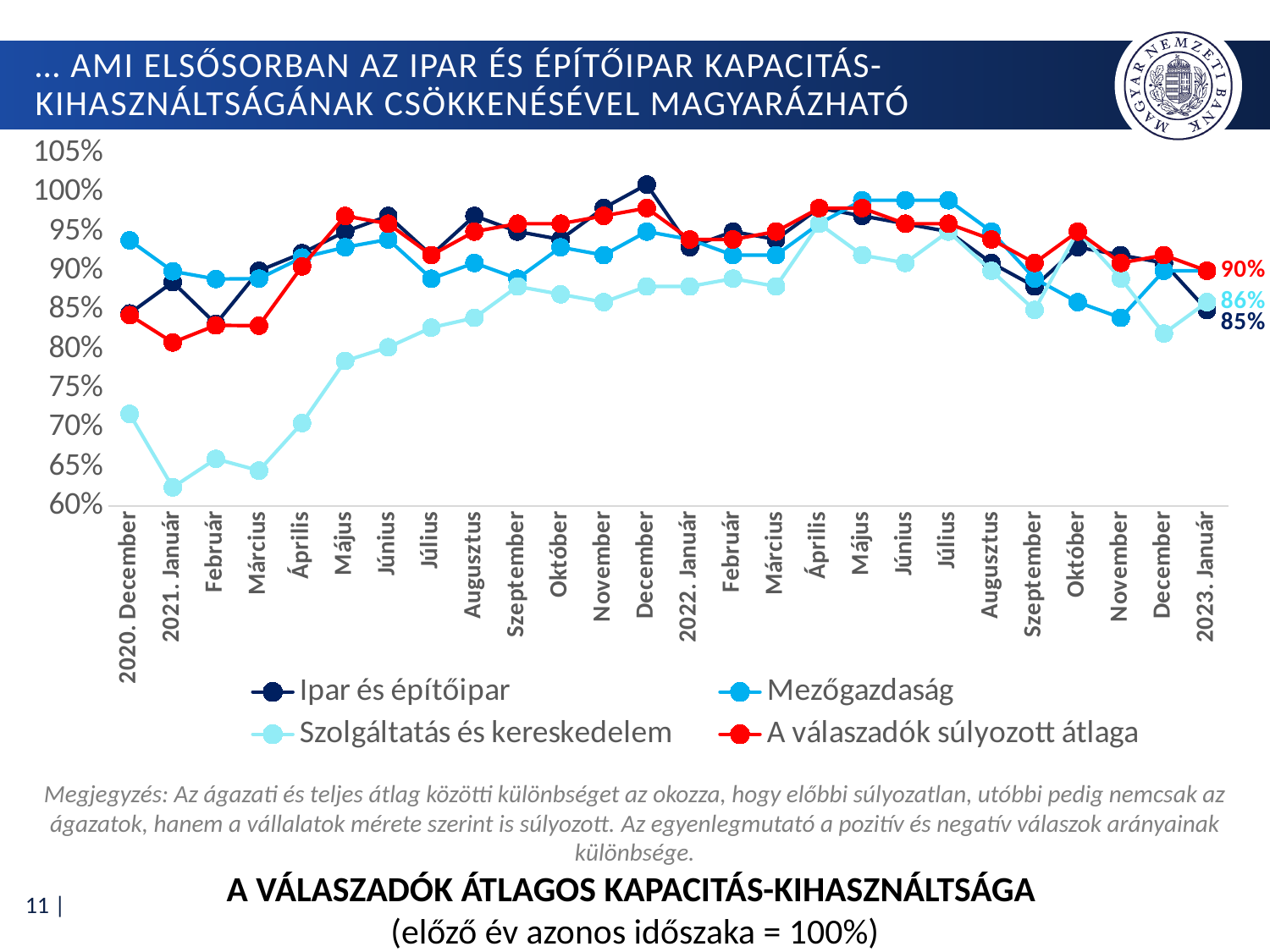
How many series does the legend list? 4 What is the value of 'A válaszadók súlyozott átlaga' in 2023. Január? 90% Is the value for 'Ipar és építőipar' in 2021 December greater or less than 100%? greater In which month does 'Szolgáltatás és kereskedelem' reach its lowest value? 2021. Január What is the value of 'Ipar és építőipar' in 2023. Január? 85% How many months (points) are shown along the x axis? 26 In which month does 'Ipar és építőipar' reach its highest value? 2021 December In 2023. Január, what is the difference between 'A válaszadók súlyozott átlaga' and 'Ipar és építőipar'? 5 percentage points Is the value for 'Szolgáltatás és kereskedelem' in 2021. Január greater or less than 65%? less In 2021. Január, which is larger: 'Ipar és építőipar' or 'Szolgáltatás és kereskedelem'? Ipar és építőipar What is the value of 'Szolgáltatás és kereskedelem' in 2023. Január? 86% What kind of chart is shown on the slide? line chart